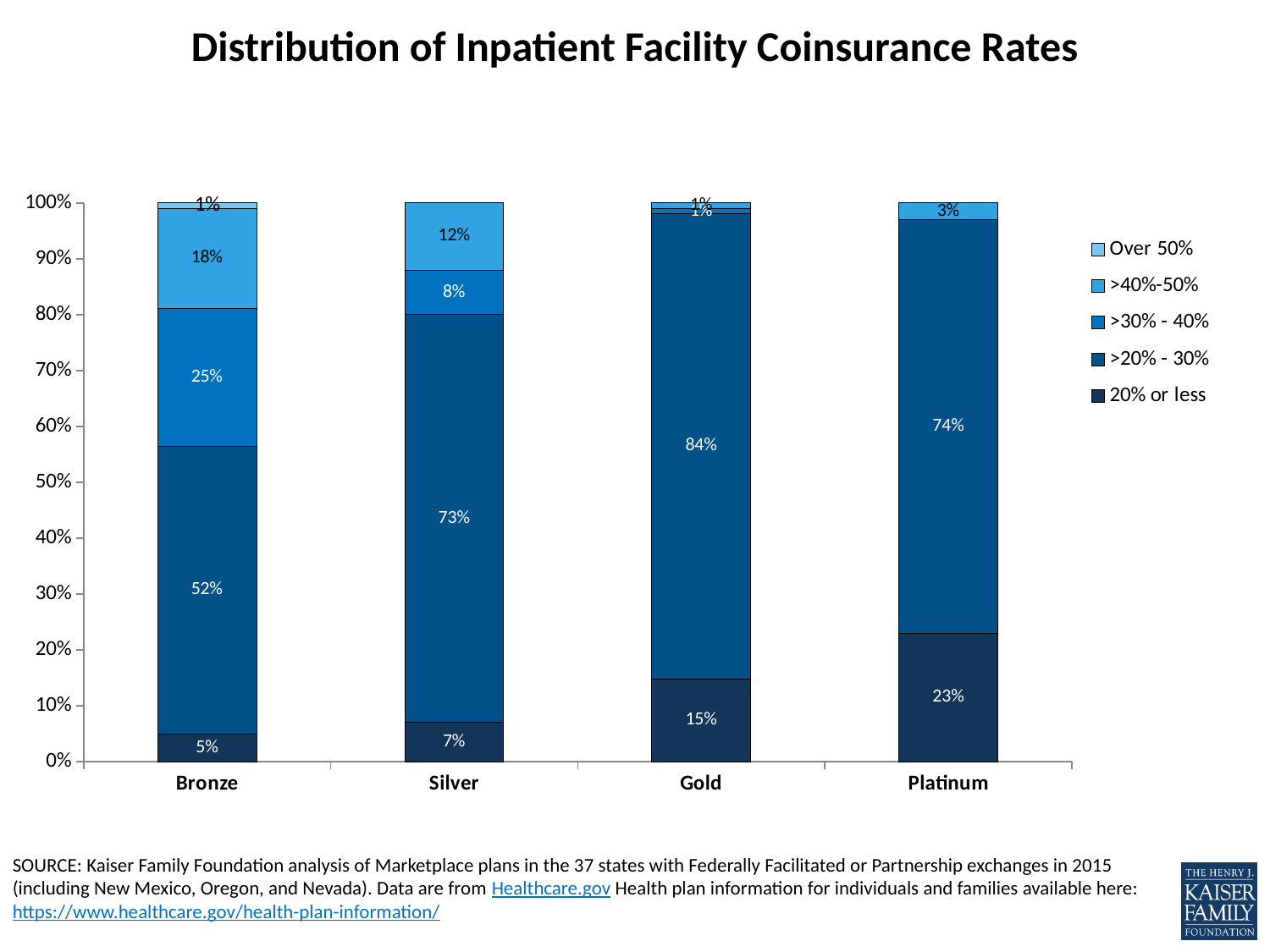
How many metal tiers (categories) are shown on the x axis? 4 What kind of chart is shown on the slide? Stacked bar chart What share of Platinum plans have a coinsurance rate of 20% or less? 23% What share of Silver plans fall in the >20% - 30% coinsurance range? 73% What share of Silver plans fall in the >40%-50% range? 12% What share of Bronze plans have an inpatient facility coinsurance rate of 20% or less? 5% Which metal tier has the smallest share of plans with coinsurance of 20% or less? Bronze Which metal tier has the largest share of plans with coinsurance of 20% or less? Platinum How many series does the legend list? 5 How many percentage points higher is the >20% - 30% share for Gold than for Silver? 11 percentage points What share of Gold plans fall in the >20% - 30% coinsurance range? 84% Which has a larger share of plans in the >30% - 40% range, Bronze or Silver? Bronze